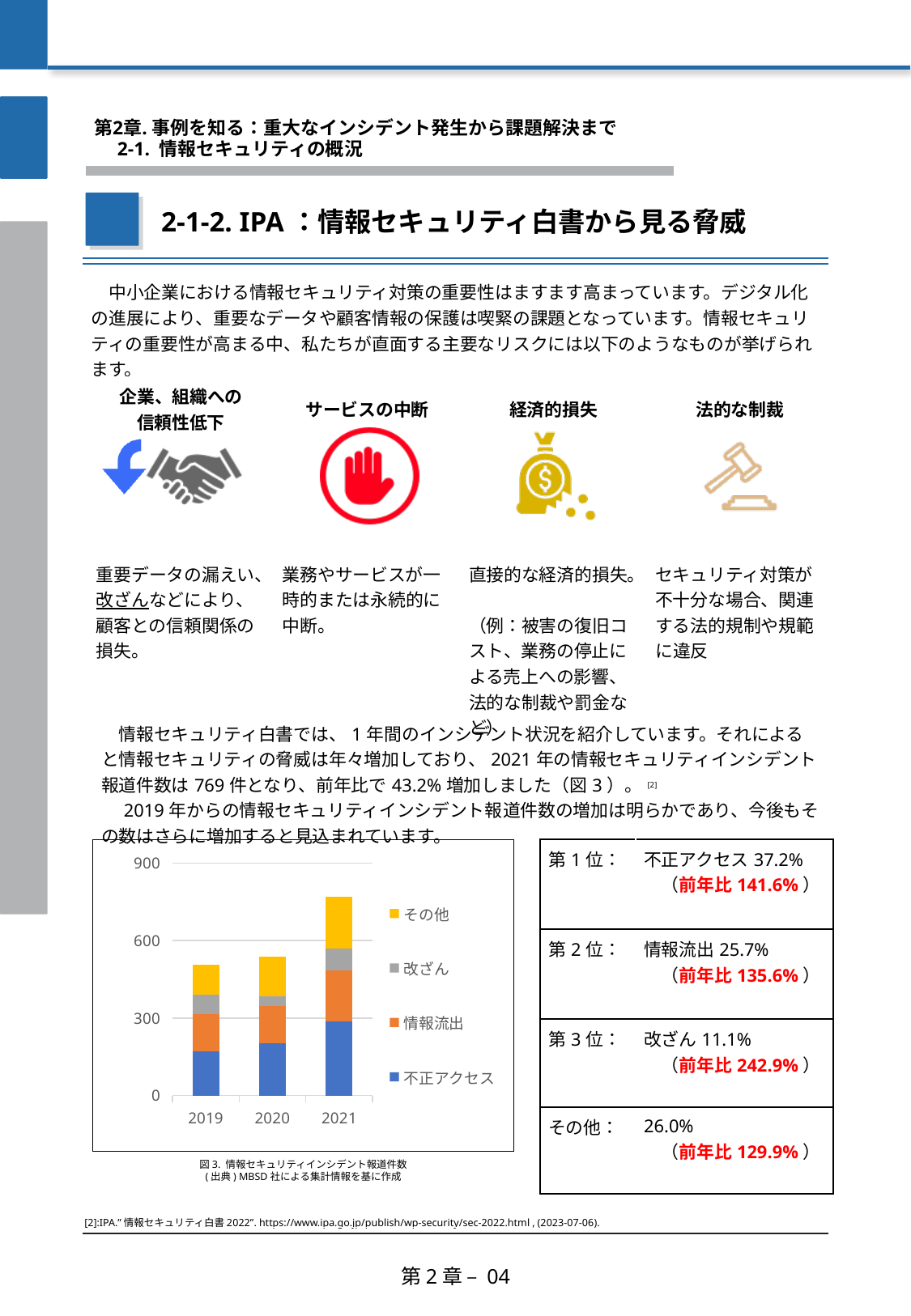
Is the total for 2021 greater or less than 600? greater How many years (categories) are shown on the x axis of the chart? 3 According to the slide text, how many security incident reports were there in 2021 (図3)? 769 What kind of chart is shown in 図3? bar chart Which year has the highest total stacked bar in the chart? 2021 Is the total for 2019 greater or less than 600? less Which is larger, the total bar for 2021 or the total bar for 2019? 2021 Is the 不正アクセス value for 2019 greater or less than 300? less Do the total incident counts rise or fall from 2019 to 2021? rise Which series is shown at the bottom of each stacked bar? 不正アクセス How many series does the chart's legend list? 4